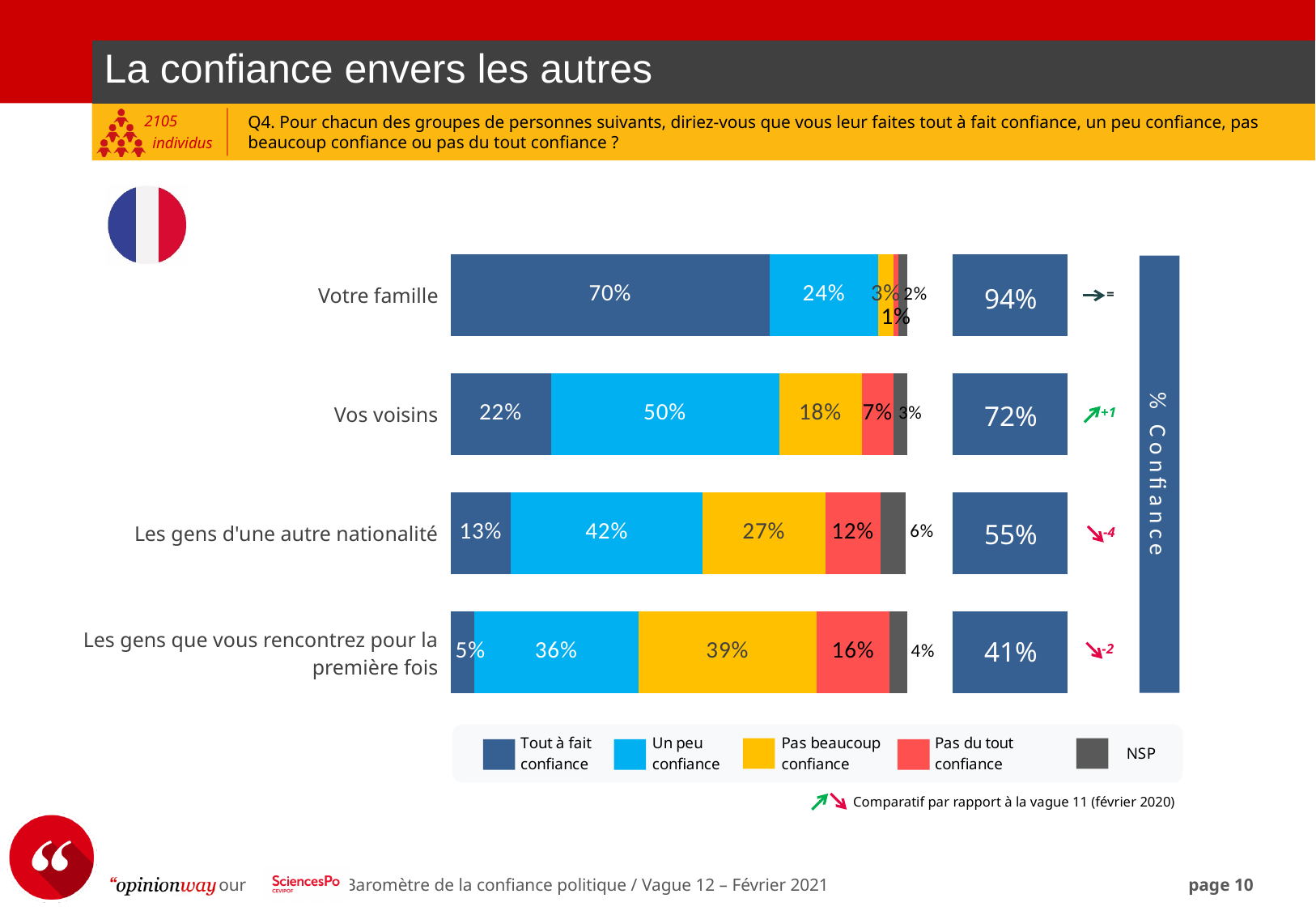
Which group has the highest '% Confiance' figure? Votre famille What kind of chart is shown on the slide? Stacked bar chart What is the '% Confiance' figure shown for 'Vos voisins'? 72% Which is larger: the 'Un peu confiance' value for 'Vos voisins' or for 'Les gens d'une autre nationalité'? Vos voisins Which group has the lowest 'Tout à fait confiance' value? Les gens que vous rencontrez pour la première fois How many groups of people are shown in the chart? 4 What is the 'Pas beaucoup confiance' value for 'Les gens que vous rencontrez pour la première fois'? 39% What is the 'Un peu confiance' value for 'Vos voisins'? 50% What is the 'Pas du tout confiance' value for 'Les gens d'une autre nationalité'? 12% How many series does the legend list? 5 What percentage of respondents say 'Tout à fait confiance' for 'Votre famille'? 70% What is the difference between the '% Confiance' figures for 'Votre famille' and 'Les gens d'une autre nationalité'? 39 points